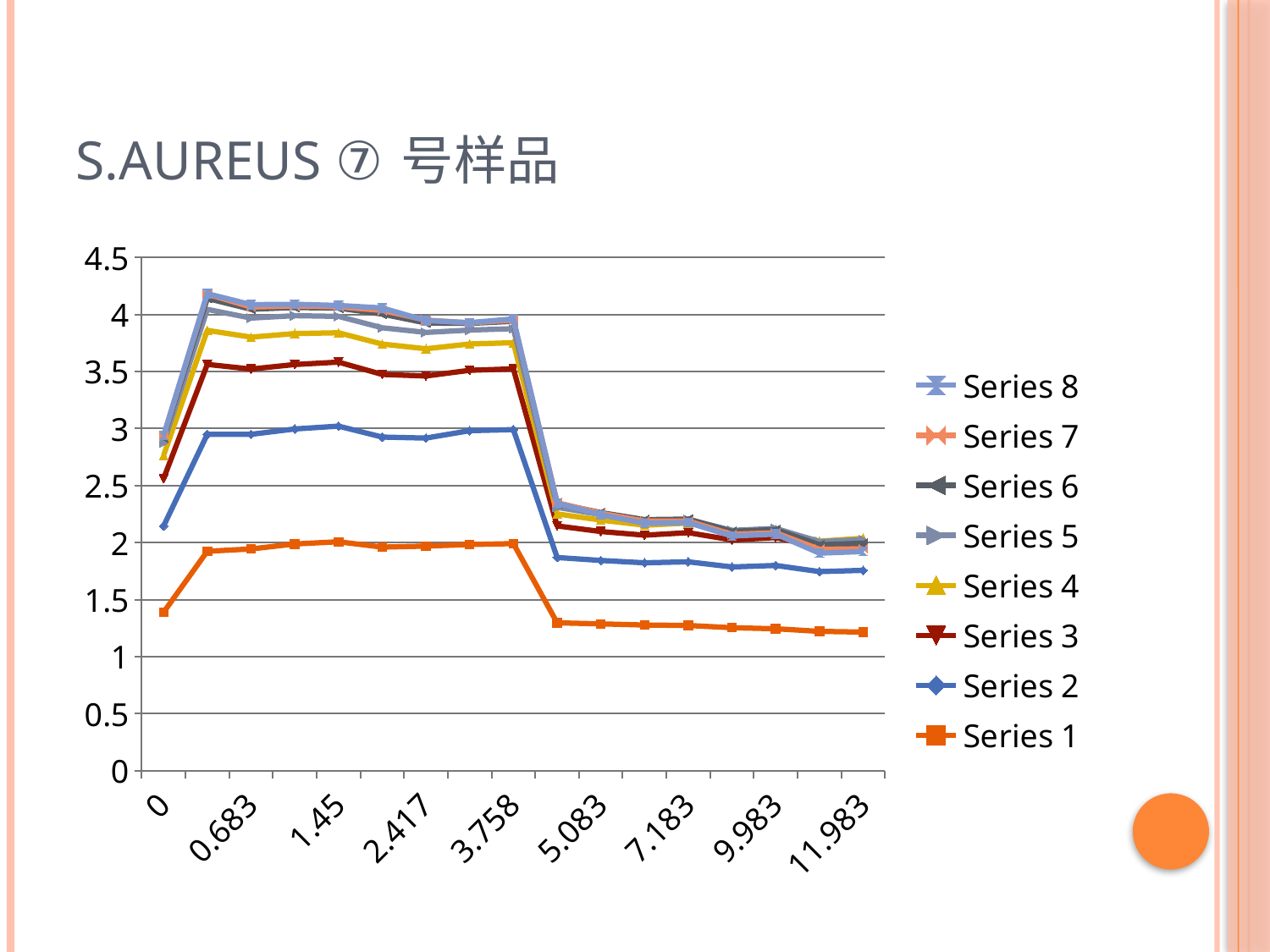
How many series does the legend list? 8 What kind of chart is shown on the slide? line chart Is the value for Series 1 at x = 11.983 greater or less than 1.5? less What is the title of the slide containing the chart? S.AUREUS ⑦ 号样品 Is the value for Series 2 at x = 11.983 greater or less than 2? less Is the value for Series 1 at x = 0 greater or less than 2? less Do the values for Series 1 rise or fall between x = 3.758 and x = 5.083? fall